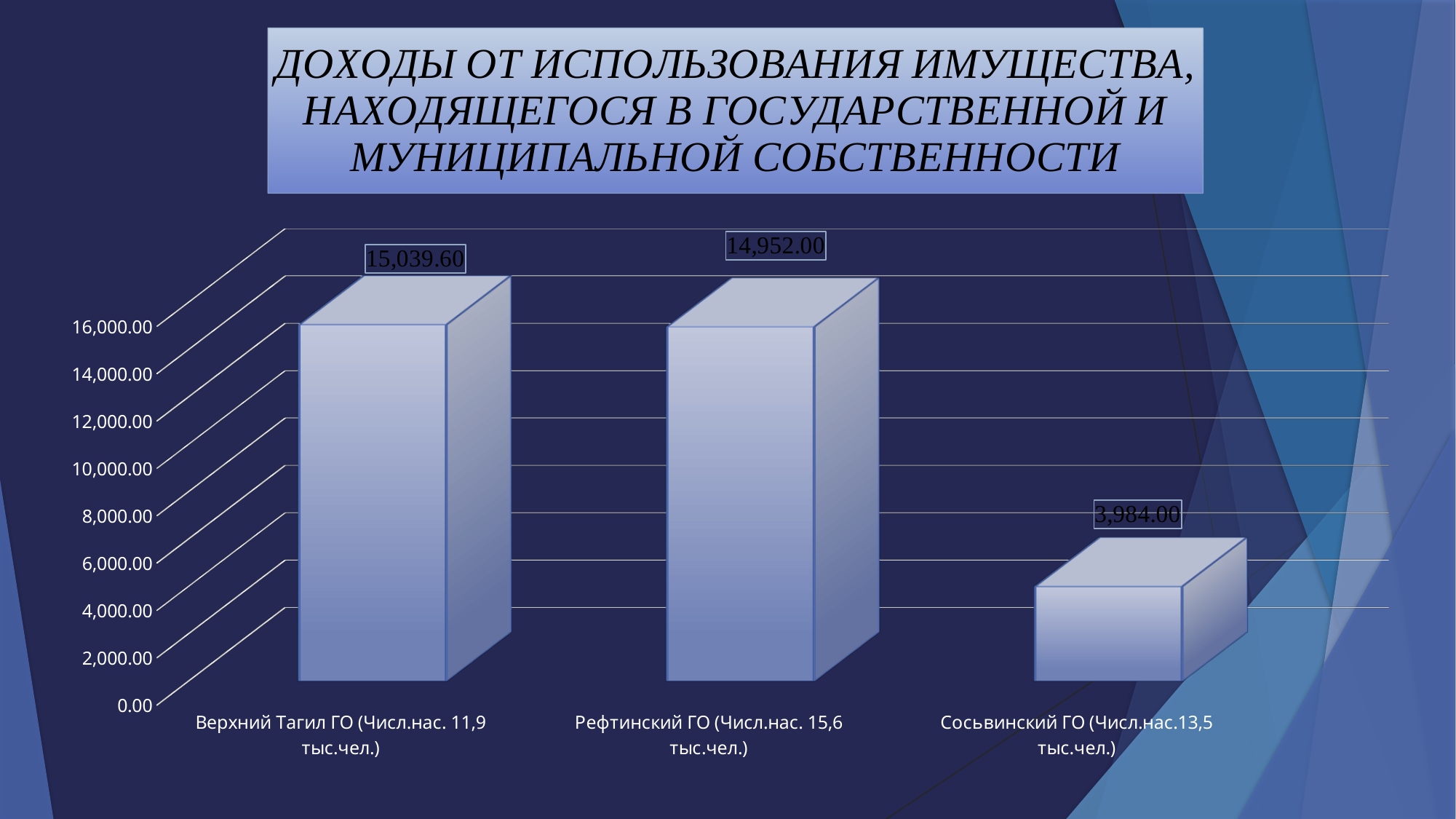
Which category has the lowest value? Сосьвинский ГО What is the difference between the values for Рефтинский ГО and Сосьвинский ГО? 10,968.00 What kind of chart is shown on the slide? bar chart What is the difference between the values for Верхний Тагил ГО and Рефтинский ГО? 87.60 What is the value for Верхний Тагил ГО? 15,039.60 Is the value for Сосьвинский ГО greater or less than 6,000.00? less Which is larger, the value for Рефтинский ГО or the value for Сосьвинский ГО? Рефтинский ГО What is the value for Рефтинский ГО? 14,952.00 Which category has the highest value? Верхний Тагил ГО Is the value for Рефтинский ГО greater or less than 10,000.00? greater How many categories are shown on the chart? 3 What is the value for Сосьвинский ГО? 3,984.00